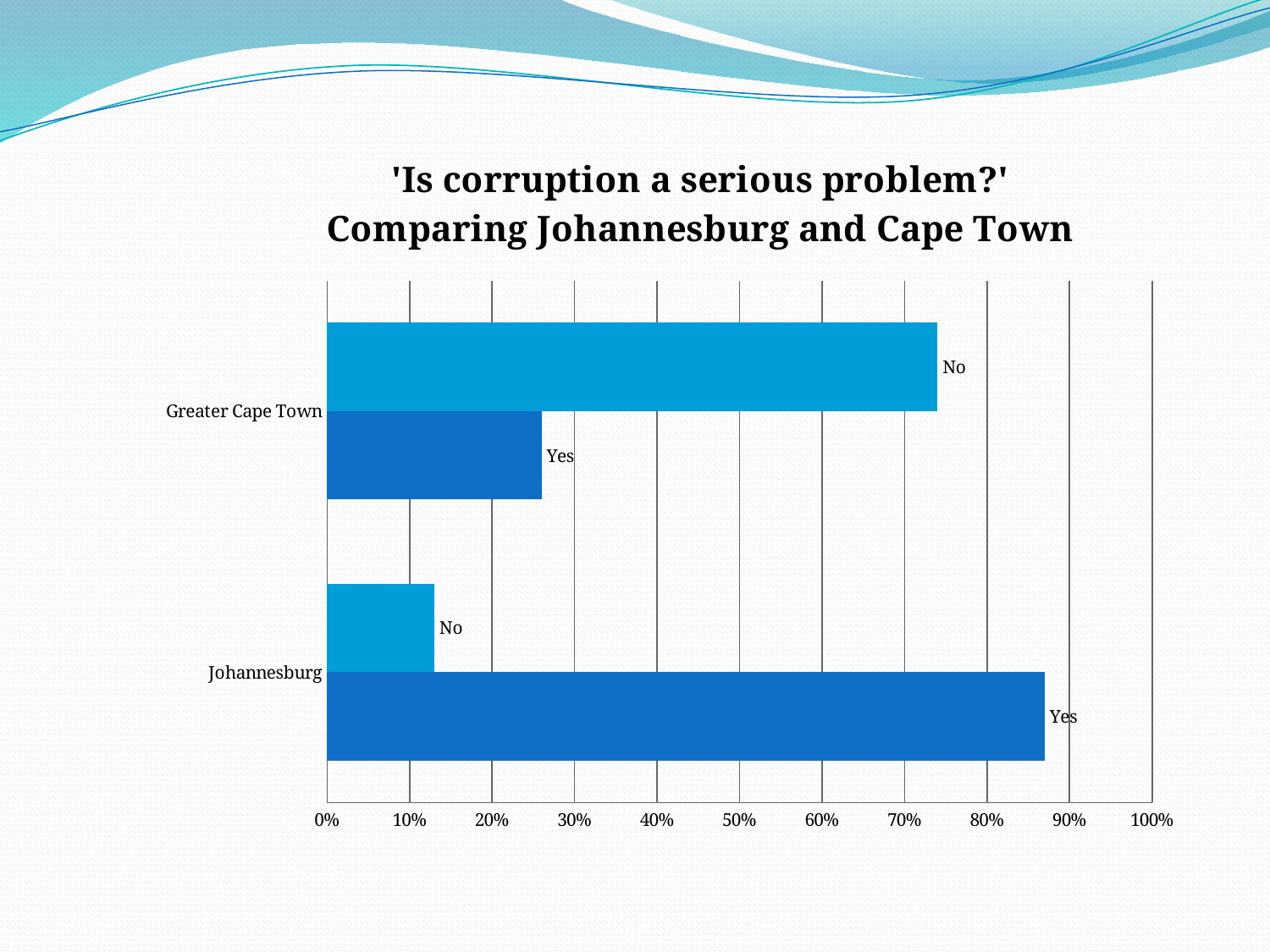
Which city has the larger 'Yes' value? Johannesburg Is the 'No' value for Greater Cape Town greater or less than 70%? greater Is the 'Yes' value for Greater Cape Town greater or less than 30%? less What question does the chart title say was asked? 'Is corruption a serious problem?' Which bar on the chart is the longest? Johannesburg Yes For Greater Cape Town, which response is larger, 'Yes' or 'No'? No For Johannesburg, which response is larger, 'Yes' or 'No'? Yes What kind of chart is shown on the slide? bar chart How many categories (cities) are shown on the chart? 2 Is the 'Yes' value for Johannesburg greater or less than 80%? greater